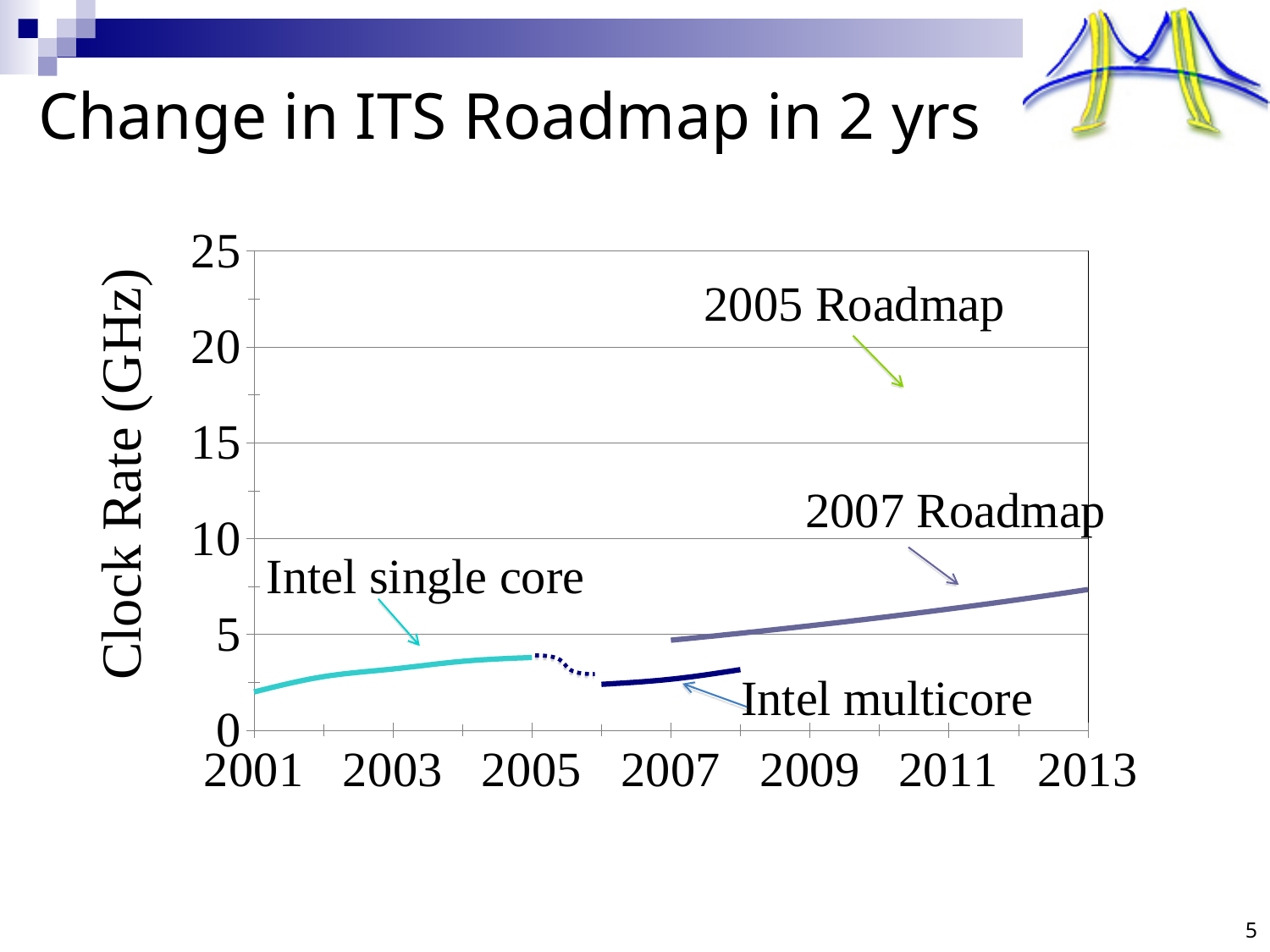
Does the Intel single core line rise or fall from 2001 to 2005? rise What is the label of the vertical axis of the chart? Clock Rate (GHz) Is the clock rate of the Intel single core line in 2005 greater or less than 5 GHz? less Is the clock rate of the 2007 Roadmap line in 2013 greater or less than 5 GHz? greater Is the clock rate of the 2007 Roadmap line in 2013 greater or less than 10 GHz? less What kind of chart is shown on the slide? line chart Does the 2007 Roadmap line rise or fall from 2007 to 2013? rise What is the title of the slide containing the chart? Change in ITS Roadmap in 2 yrs Which is higher: the 2007 Roadmap clock rate in 2013 or the Intel single core clock rate in 2005? 2007 Roadmap clock rate in 2013 How many year labels are shown on the horizontal axis? 7